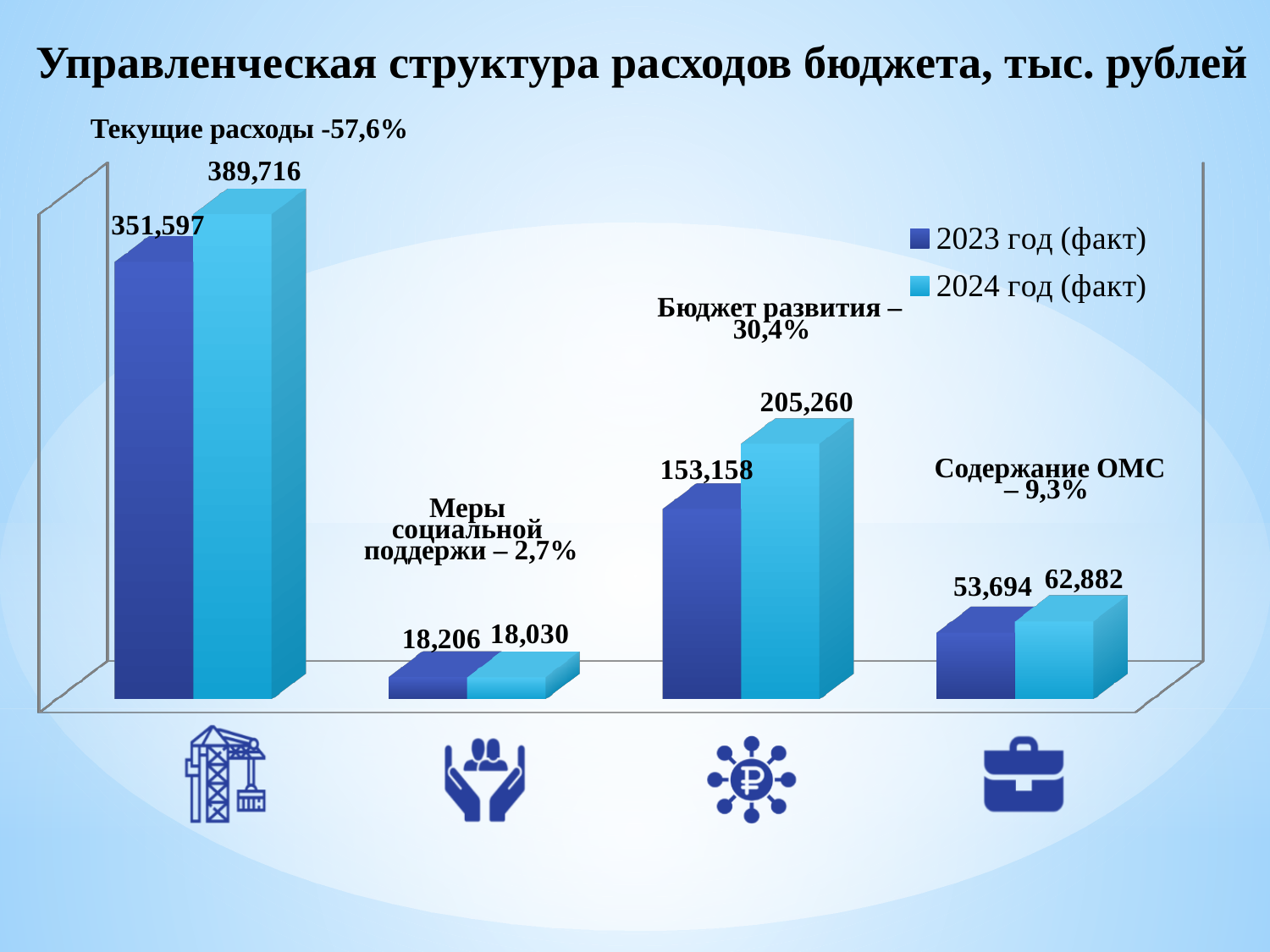
How many series does the legend list? 2 How many categories are shown in the chart? 4 What is the value for Бюджет развития in the 2024 год (факт) series? 205,260 What is the difference between the 2024 год (факт) and 2023 год (факт) values for Содержание ОМС? 9,188 Which category has the highest value in the 2024 год (факт) series? Текущие расходы Which is larger for Текущие расходы: the 2023 год (факт) value or the 2024 год (факт) value? 2024 год (факт) What is the value for Содержание ОМС in the 2023 год (факт) series? 53,694 What is the value for Текущие расходы in the 2023 год (факт) series? 351,597 What is the value for Меры социальной поддержки in the 2024 год (факт) series? 18,030 What kind of chart is shown on the slide? Bar chart What is the difference between the 2024 год (факт) and 2023 год (факт) values for Бюджет развития? 52,102 Which category has the lowest value in the 2023 год (факт) series? Меры социальной поддержки